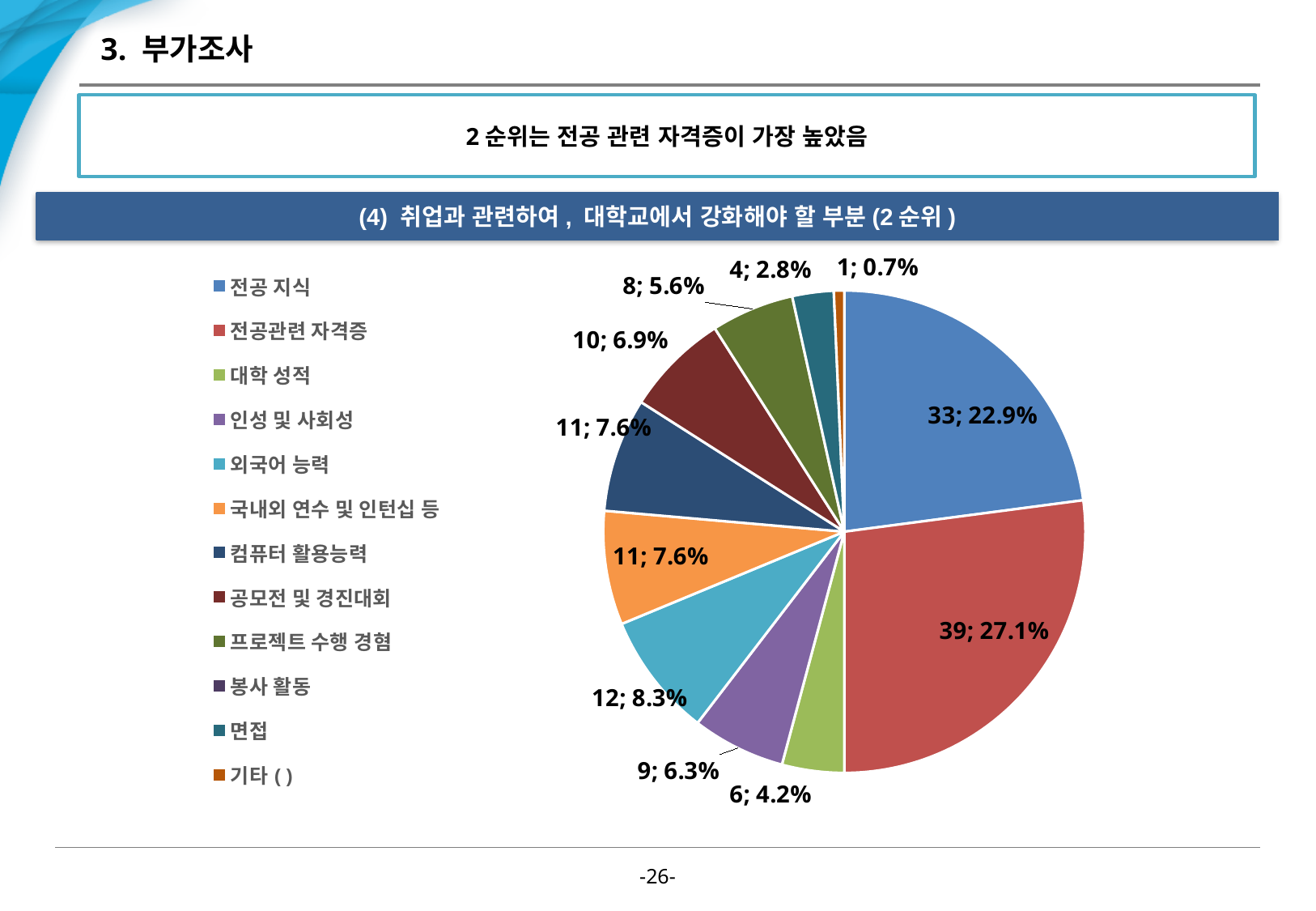
How many entries does the legend list? 12 What is the count and percentage shown for 전공관련 자격증? 39; 27.1% Which has a larger slice, 외국어 능력 or 인성 및 사회성? 외국어 능력 What share of the pie does 대학 성적 represent? 4.2% What is the title of the chart? (4) 취업과 관련하여, 대학교에서 강화해야 할 부분 (2 순위) What kind of chart is shown on the slide? Pie chart What is the count shown for 컴퓨터 활용능력? 11 What is the difference in count between 전공관련 자격증 and 전공 지식? 6 What share of the pie does 공모전 및 경진대회 represent? 6.9% What is the count shown for 프로젝트 수행 경험? 8 Which category has the largest slice of the pie? 전공관련 자격증 What is the count and percentage shown for 전공 지식? 33; 22.9%